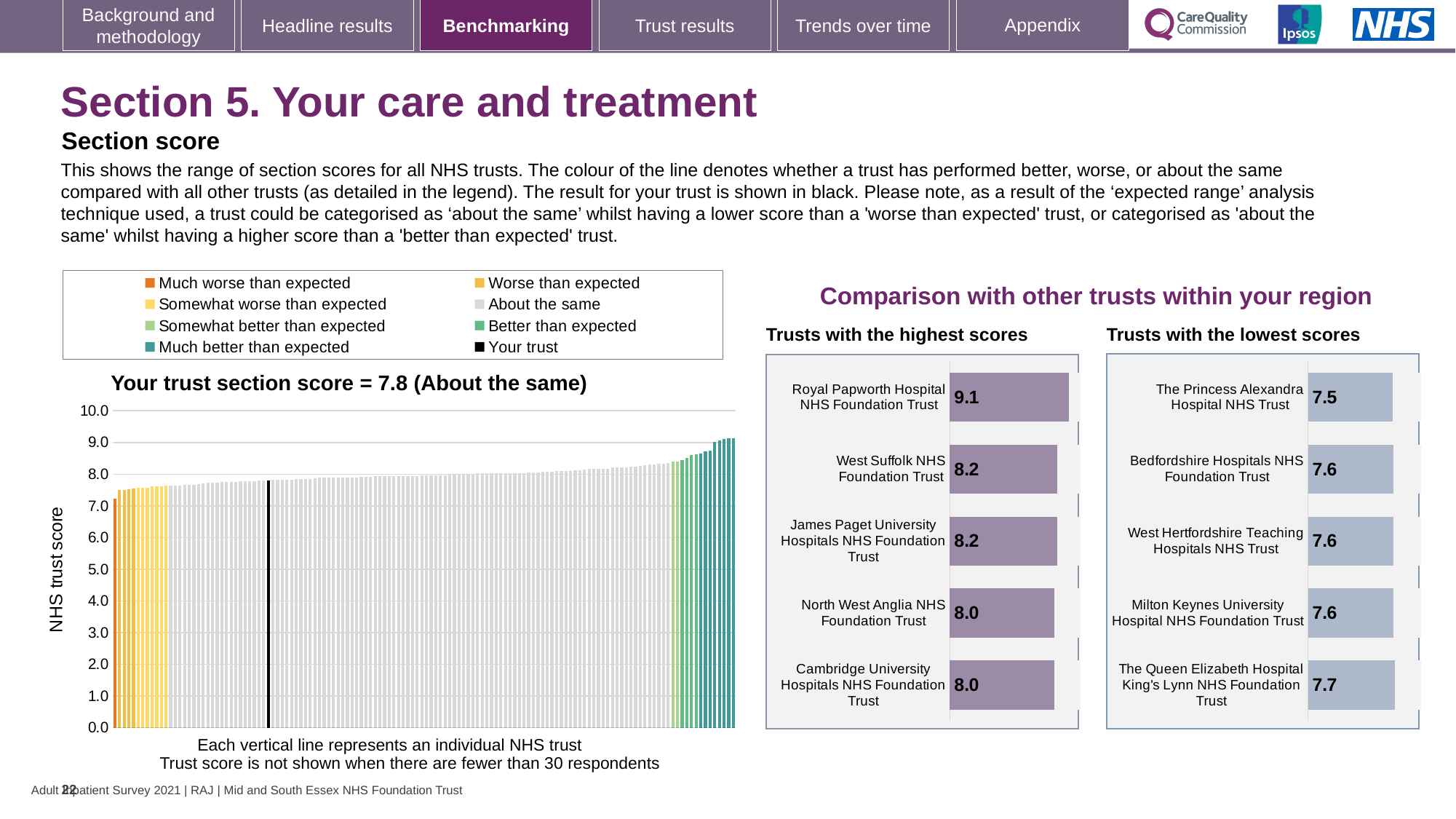
In the 'Trusts with the highest scores' chart, what is the score for Royal Papworth Hospital NHS Foundation Trust? 9.1 In the 'Trusts with the highest scores' chart, which trust has the highest score? Royal Papworth Hospital NHS Foundation Trust In the 'Trusts with the lowest scores' chart, which trust has the lowest score? The Princess Alexandra Hospital NHS Trust In the 'Trusts with the lowest scores' chart, which has the larger score: The Queen Elizabeth Hospital King's Lynn NHS Foundation Trust or The Princess Alexandra Hospital NHS Trust? The Queen Elizabeth Hospital King's Lynn NHS Foundation Trust In the 'Trusts with the lowest scores' chart, what is the difference between the scores of The Queen Elizabeth Hospital King's Lynn NHS Foundation Trust and The Princess Alexandra Hospital NHS Trust? 0.2 What kind of chart is the main section score chart on the left? Bar chart In the 'Trusts with the lowest scores' chart, what is the score for Milton Keynes University Hospital NHS Foundation Trust? 7.6 In the 'Trusts with the lowest scores' chart, what is the score for The Princess Alexandra Hospital NHS Trust? 7.5 How many entries does the legend of the main section score chart list? 8 In the 'Trusts with the highest scores' chart, what is the difference between the scores of Royal Papworth Hospital NHS Foundation Trust and Cambridge University Hospitals NHS Foundation Trust? 1.1 In the main section score chart on the left, what is your trust's section score? 7.8 In the 'Trusts with the highest scores' chart, how many trusts are shown? 5